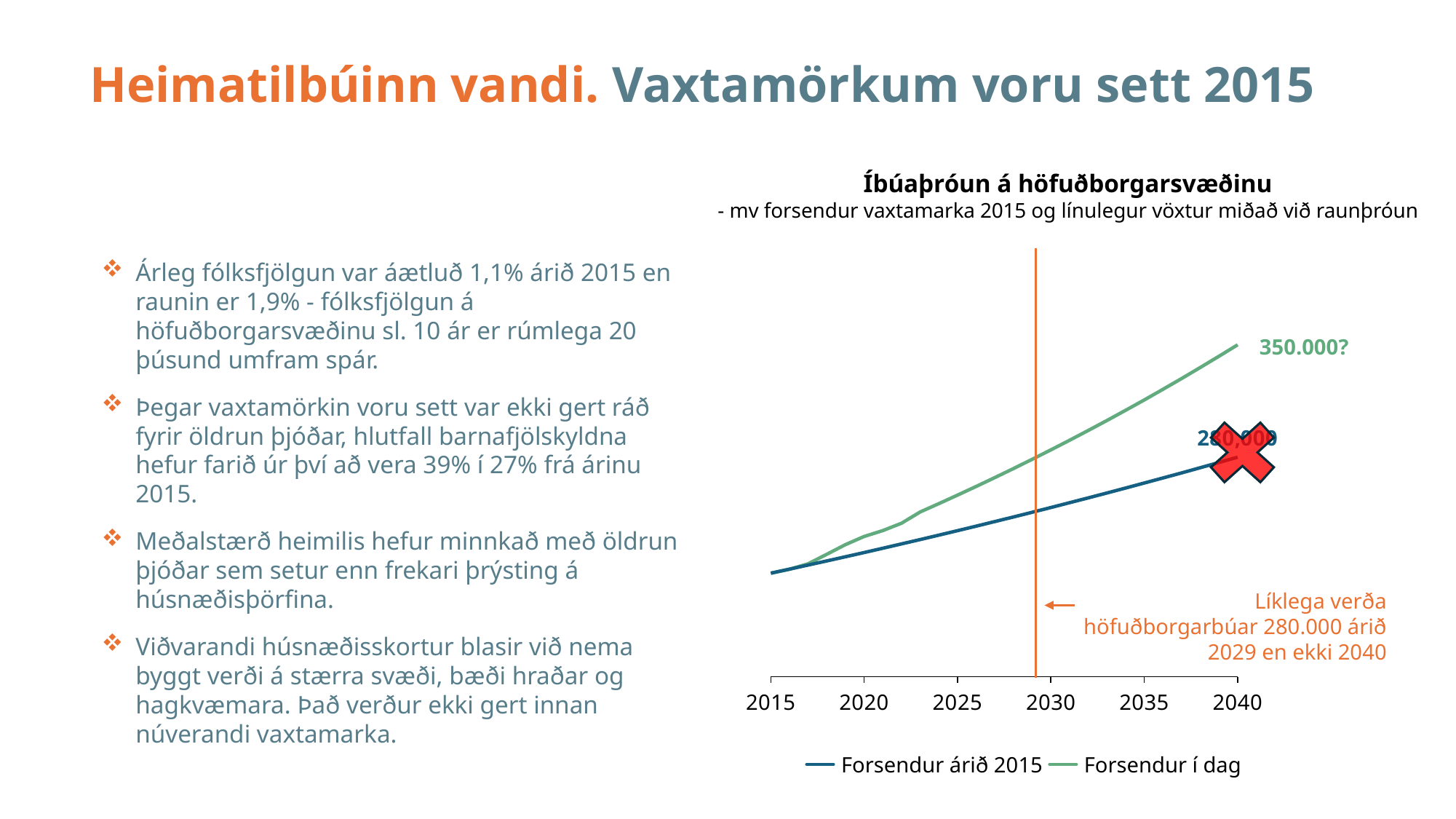
Which series is higher in 2040, 'Forsendur árið 2015' or 'Forsendur í dag'? Forsendur í dag What is the title of the chart? Íbúaþróun á höfuðborgarsvæðinu What kind of chart is shown on the slide? line chart Do the values of the 'Forsendur í dag' series rise or fall from 2015 to 2040? rise What is the last year shown on the x axis? 2040 How many year tick labels are shown on the x axis? 6 What value label is printed at the 2040 end of the 'Forsendur í dag' line? 350.000? What are the two series named in the chart legend? Forsendur árið 2015 and Forsendur í dag What is the first year shown on the x axis? 2015 How many series does the chart legend list? 2 Do the values of the 'Forsendur árið 2015' series rise or fall along the x axis? rise According to the annotation, in which year will the capital area population likely reach 280.000? 2029